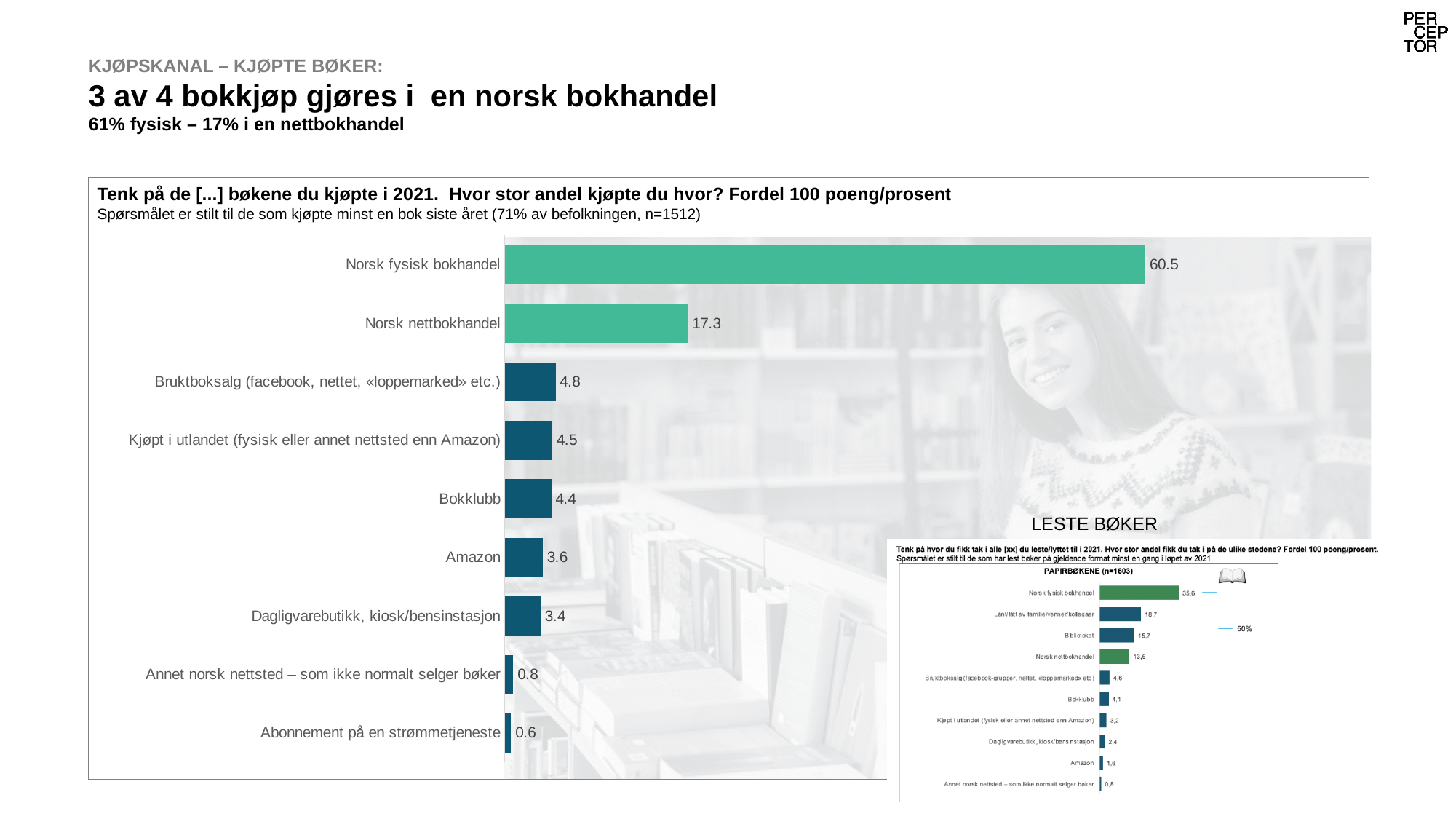
In the main chart (kjøpte bøker), what is the value for Amazon? 3.6 In the inset chart (PAPIRBØKENE, leste bøker), what is the value for Norsk fysisk bokhandel? 35,6 In the main chart (kjøpte bøker), what is the value for Norsk fysisk bokhandel? 60.5 How many categories does the main chart (kjøpte bøker) show? 9 In the inset chart (PAPIRBØKENE, leste bøker), what is the value for Biblioteket? 15,7 How many categories does the inset chart (PAPIRBØKENE, leste bøker) show? 10 In the main chart (kjøpte bøker), what is the value for Norsk nettbokhandel? 17.3 In the main chart (kjøpte bøker), which is larger: Bokklubb or Dagligvarebutikk, kiosk/bensinstasjon? Bokklubb In the main chart (kjøpte bøker), which category has the lowest value? Abonnement på en strømmetjeneste In the main chart (kjøpte bøker), which category has the highest value? Norsk fysisk bokhandel In the main chart (kjøpte bøker), what is the difference between Norsk fysisk bokhandel and Norsk nettbokhandel? 43.2 What type of chart is the main chart (kjøpte bøker)? Bar chart